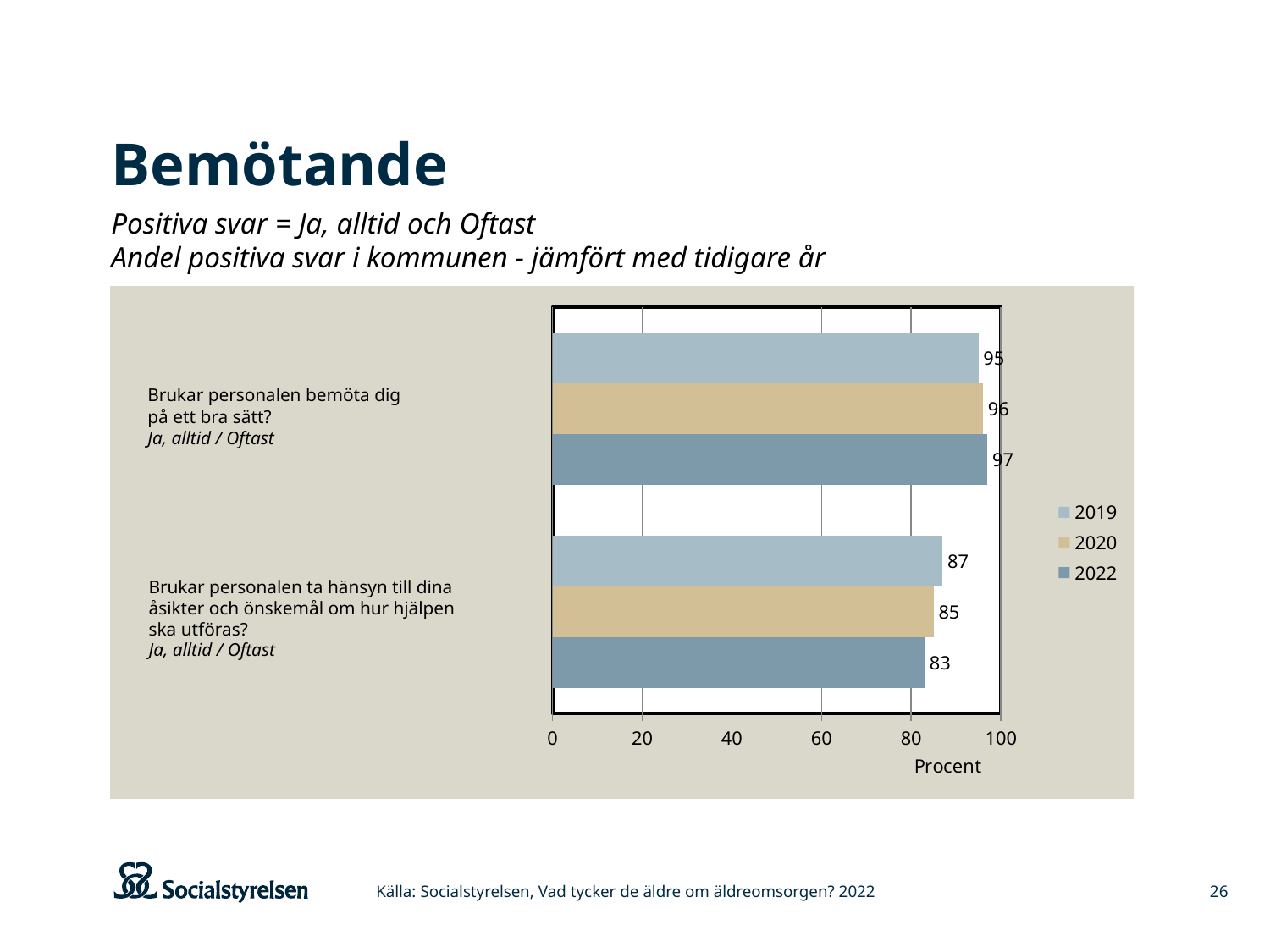
Which is larger for 2020: the value for "Brukar personalen bemöta dig på ett bra sätt?" or for "Brukar personalen ta hänsyn till dina åsikter och önskemål om hur hjälpen ska utföras?"? Brukar personalen bemöta dig på ett bra sätt? What is the 2019 value for "Brukar personalen ta hänsyn till dina åsikter och önskemål om hur hjälpen ska utföras?"? 87 How many series does the legend list? 3 What is the 2022 value for "Brukar personalen ta hänsyn till dina åsikter och önskemål om hur hjälpen ska utföras?"? 83 What is the label on the horizontal axis of the chart? Procent What is the 2020 value for "Brukar personalen bemöta dig på ett bra sätt?"? 96 What is the 2022 value for "Brukar personalen bemöta dig på ett bra sätt?"? 97 What kind of chart is shown on the slide? bar chart What is the difference between the 2019 and 2022 values for "Brukar personalen ta hänsyn till dina åsikter och önskemål om hur hjälpen ska utföras?"? 4 Which year has the highest value for "Brukar personalen bemöta dig på ett bra sätt?"? 2022 Do the values for "Brukar personalen ta hänsyn till dina åsikter och önskemål om hur hjälpen ska utföras?" rise or fall from 2019 to 2022? fall Which year has the lowest value for "Brukar personalen ta hänsyn till dina åsikter och önskemål om hur hjälpen ska utföras?"? 2022